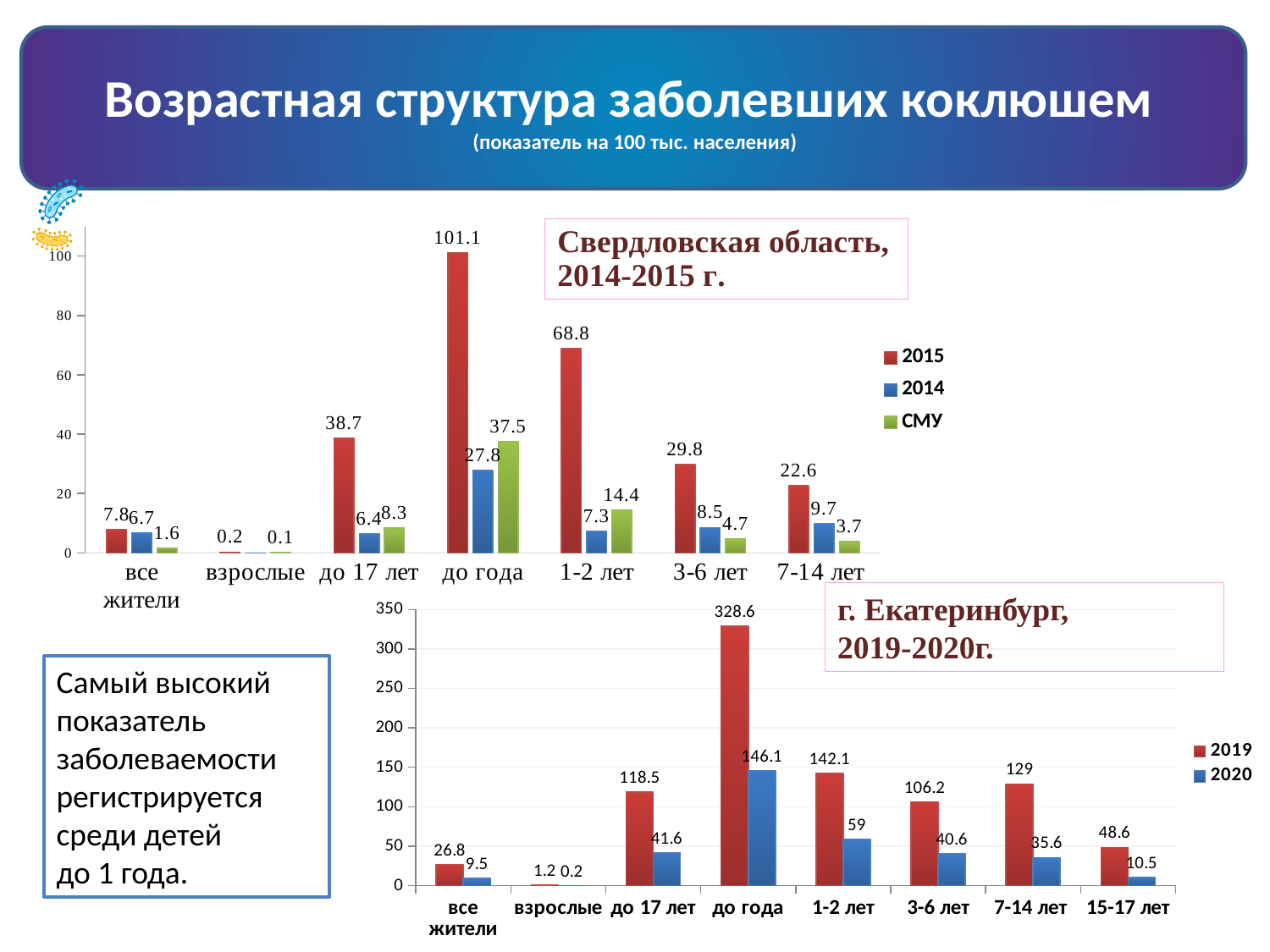
How many categories are shown on the x axis of the chart 'г. Екатеринбург, 2019-2020г.'? 8 In the chart 'Свердловская область, 2014-2015 г.', what is the 2015 value for 'до года'? 101.1 In the chart 'г. Екатеринбург, 2019-2020г.', which is larger: the 2019 value for '1-2 лет' or the 2019 value for '3-6 лет'? 1-2 лет In the chart 'Свердловская область, 2014-2015 г.', how many series does the legend list? 3 In the chart 'г. Екатеринбург, 2019-2020г.', which category has the lowest 2019 value? взрослые In the chart 'г. Екатеринбург, 2019-2020г.', what is the 2020 value for 'до года'? 146.1 In the chart 'г. Екатеринбург, 2019-2020г.', what is the difference between the 2019 and 2020 values for '15-17 лет'? 38.1 In the chart 'г. Екатеринбург, 2019-2020г.', what is the 2019 value for '7-14 лет'? 129 What type of chart is the chart 'г. Екатеринбург, 2019-2020г.'? Bar chart In the chart 'Свердловская область, 2014-2015 г.', which category has the highest 2014 value? до года In the chart 'Свердловская область, 2014-2015 г.', what is the difference between the 2015 and 2014 values for 'до 17 лет'? 32.3 In the chart 'Свердловская область, 2014-2015 г.', what is the СМУ value for '1-2 лет'? 14.4